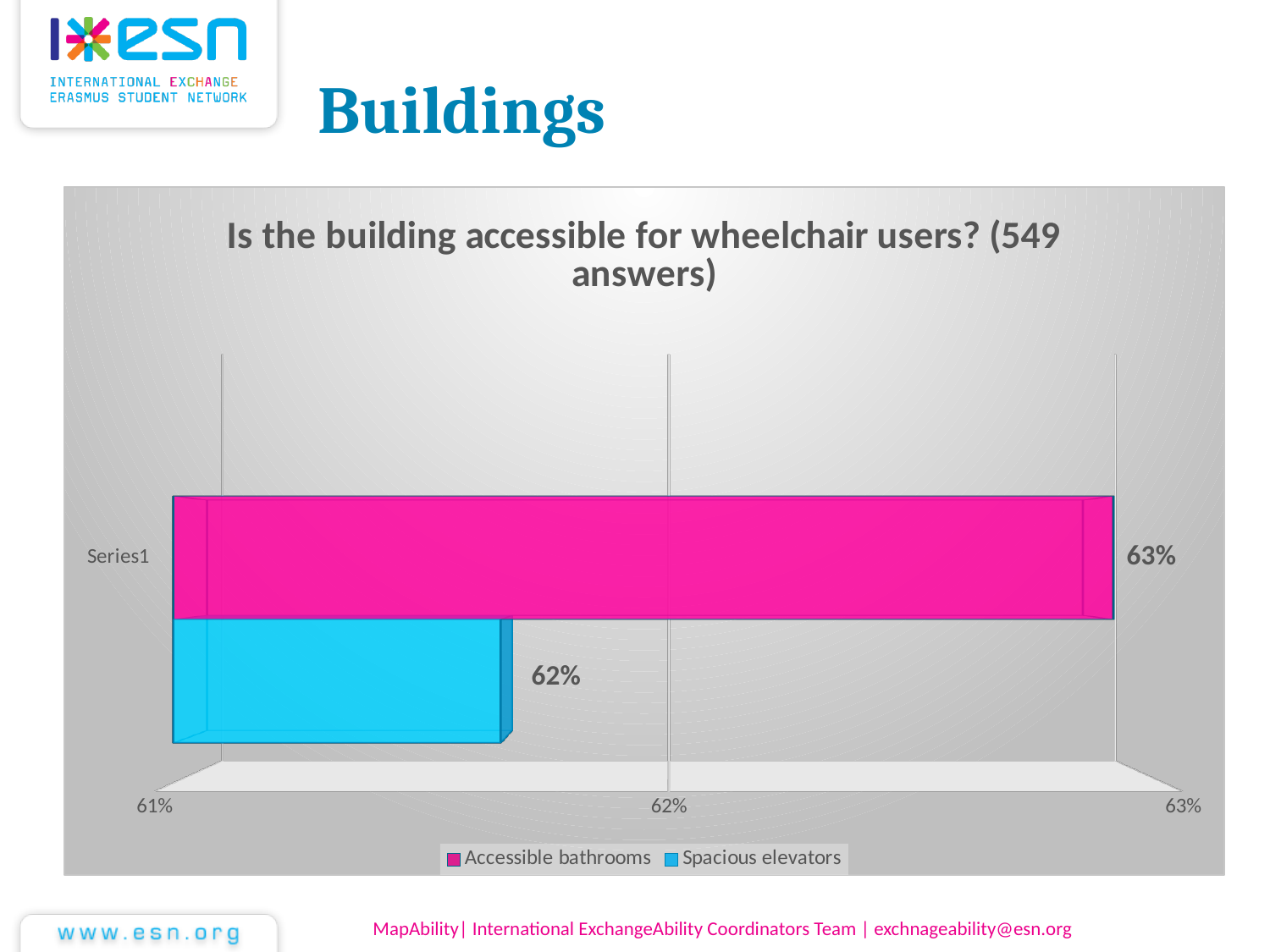
What is the title of the chart? Is the building accessible for wheelchair users? (549 answers) What colour is the bar for Spacious elevators? Blue What kind of chart is shown on the slide? Bar chart How many series does the legend list? 2 What value is shown for Spacious elevators? 62% Which series has the higher value, Accessible bathrooms or Spacious elevators? Accessible bathrooms What is the difference between the Accessible bathrooms value and the Spacious elevators value? 1% Which series has the lowest value? Spacious elevators Is the value for Accessible bathrooms greater or less than 62%? greater Which series has the highest value? Accessible bathrooms How many answers does the chart title say were collected? 549 What value is shown for Accessible bathrooms? 63%